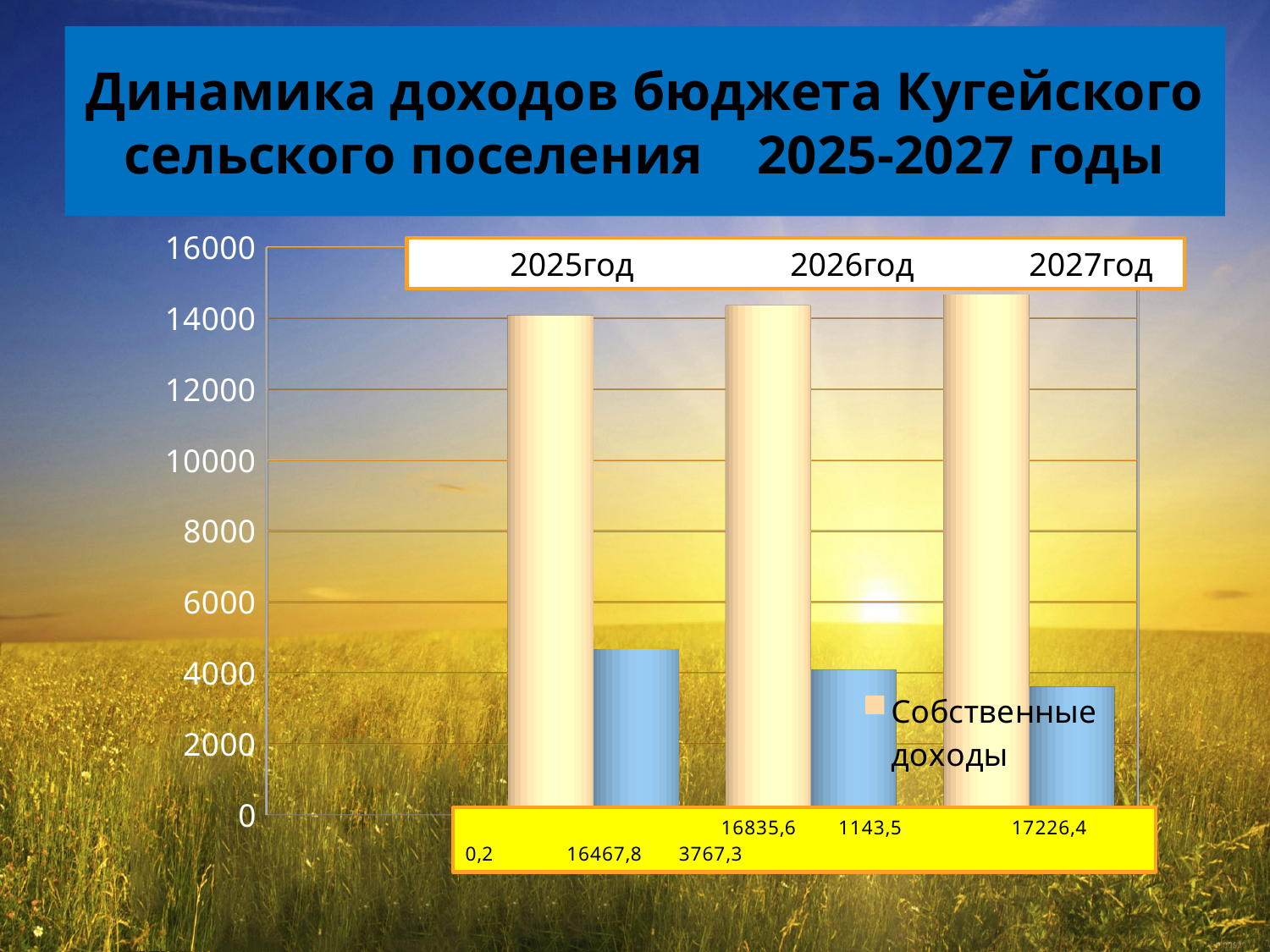
Is the value of the blue bar for 2025год greater or less than 4000? greater How many year categories are shown on the x axis of the chart? 3 Do the cream bars rise or fall from 2025год to 2027год? rise Which year has the highest cream bar? 2027год What legend entry is shown on the chart? Собственные доходы What kind of chart is shown on the slide? bar chart Which year has the lowest blue bar? 2027год Do the blue bars rise or fall from 2025год to 2027год? fall Is the value of the blue bar for 2027год greater or less than 4000? less Is the value of the tall cream bar for 2027год greater or less than 14000? greater For 2026год, which bar is larger, the cream bar or the blue bar? the cream bar